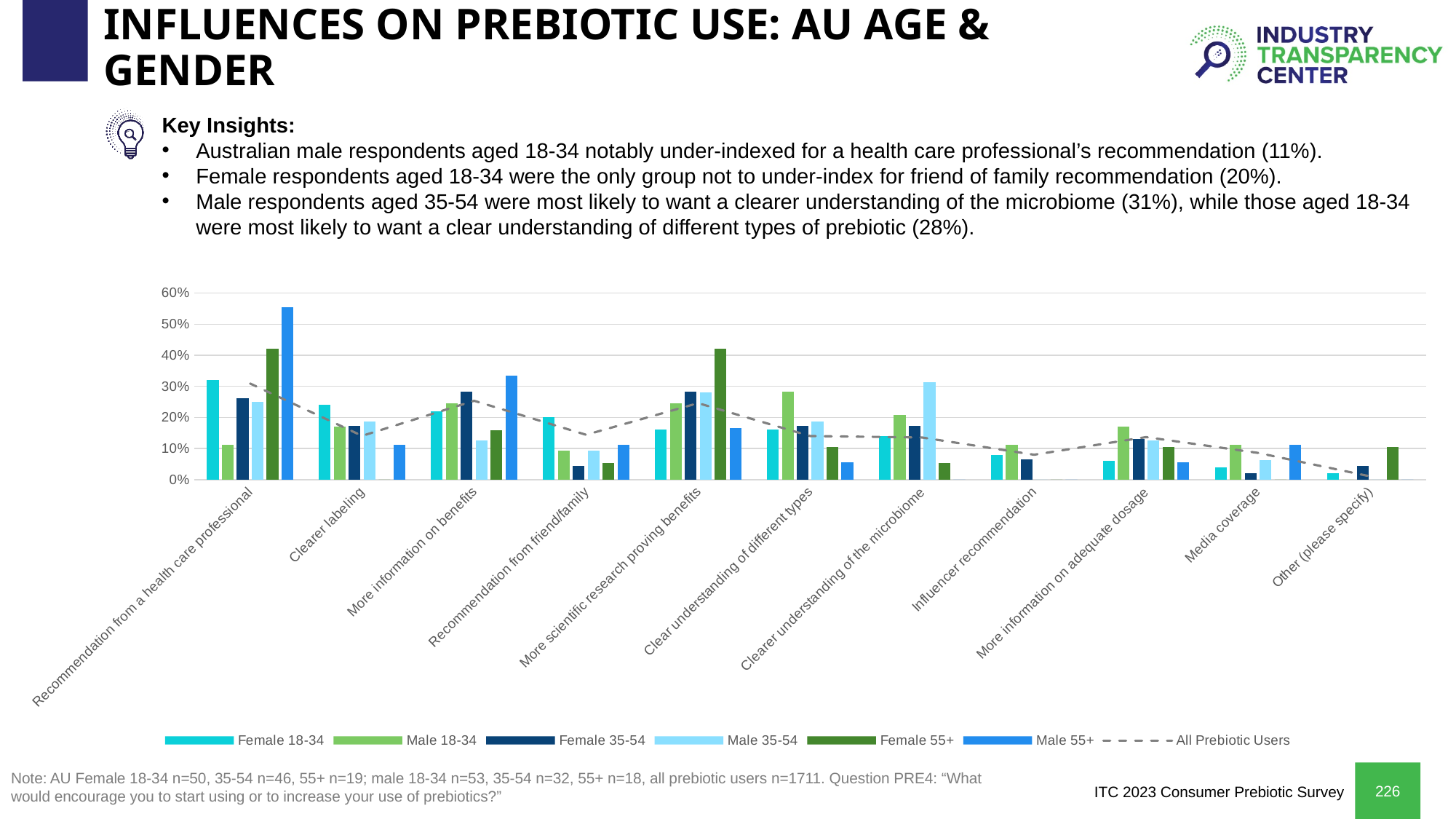
What kind of chart is shown on the slide? combination bar and line chart Does the dashed 'All Prebiotic Users' line generally rise or fall from left to right across the categories? fall Which series has the tallest bar for 'Recommendation from a health care professional'? Male 55+ How many series does the chart legend list? 7 Is the value for Female 55+ under 'More scientific research proving benefits' greater or less than 40%? greater How many categories are shown along the x axis of the chart? 11 For 'Clear understanding of different types', which is larger: Male 18-34 or Female 18-34? Male 18-34 Is the value for Male 35-54 under 'Clearer understanding of the microbiome' greater or less than 20%? greater What does the dashed grey line in the chart represent according to the legend? All Prebiotic Users Which category contains the tallest bar in the whole chart? Recommendation from a health care professional Is the value for Male 55+ under 'Recommendation from a health care professional' greater or less than 50%? greater